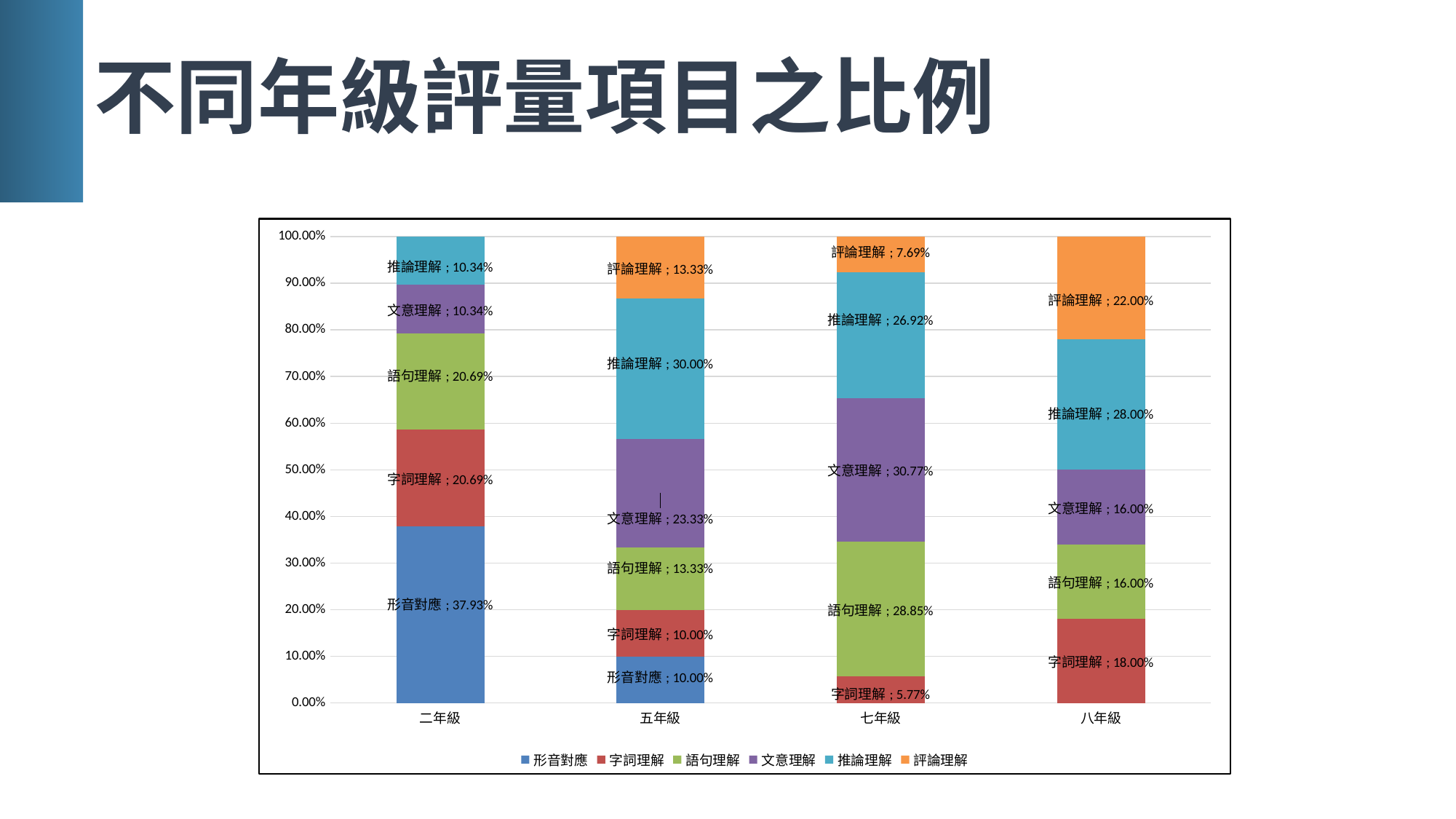
How many grade categories are shown on the x axis? 4 What is the title of the slide? 不同年級評量項目之比例 Which is larger: 評論理解 in 五年級 or 評論理解 in 七年級? 評論理解 in 五年級 What kind of chart is shown on the slide? Stacked bar chart How many series does the legend list? 6 Which grade has the highest value for 推論理解? 五年級 What is the value for 評論理解 in 八年級? 22.00% What is the value for 文意理解 in 七年級? 30.77% What is the value for 形音對應 in 二年級? 37.93% Which grade has the lowest value for 字詞理解? 七年級 What is the difference between 文意理解 in 七年級 and 文意理解 in 八年級? 14.77% What is the value for 推論理解 in 五年級? 30.00%